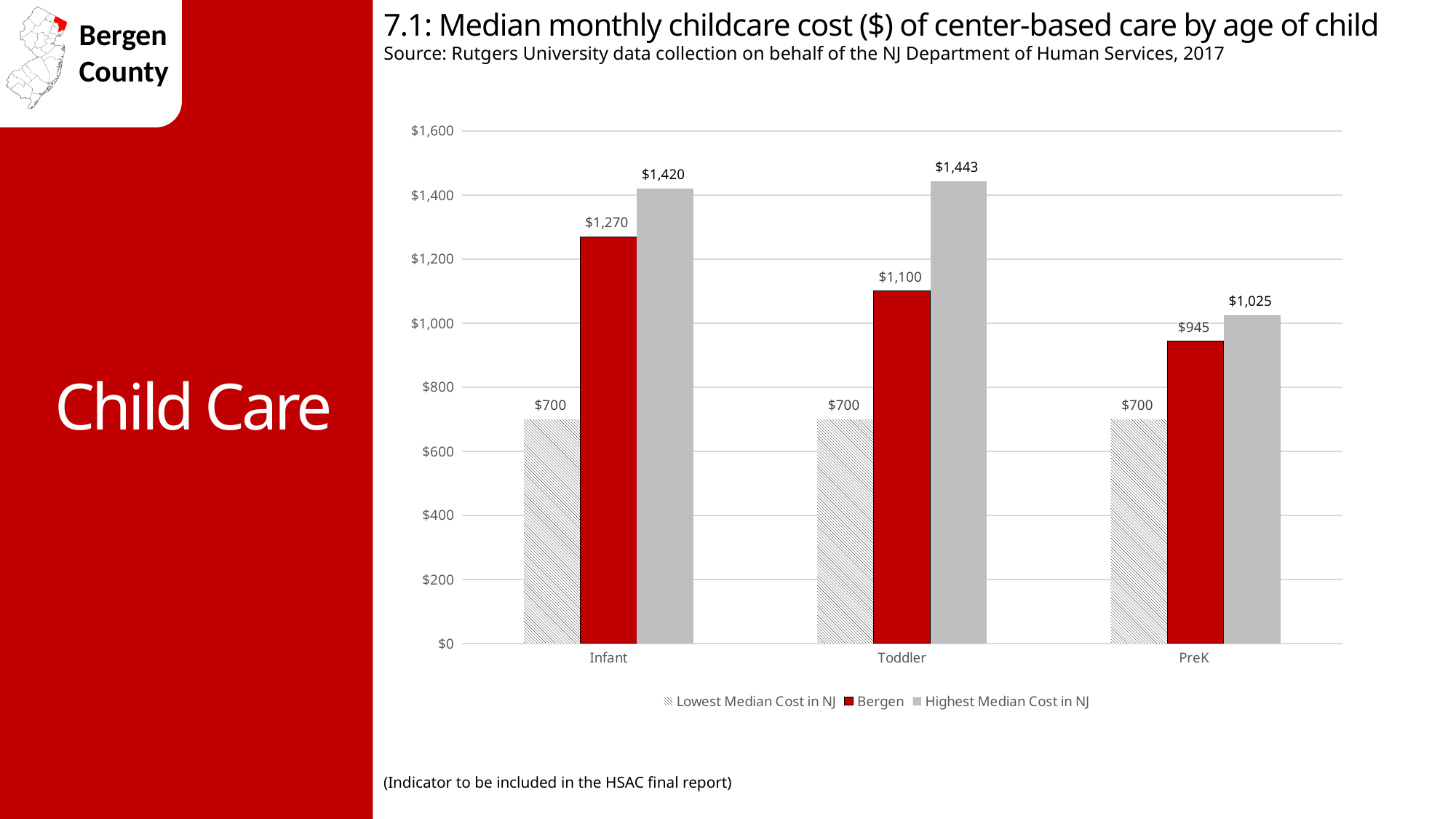
For which age group is the Highest Median Cost in NJ lowest? PreK What is the Highest Median Cost in NJ for Toddler care? $1,443 Which is larger: the Bergen cost for Toddler care or the Bergen cost for PreK care? Toddler Is the Bergen cost for PreK care greater or less than $1,000? less What is the difference between the Highest Median Cost in NJ and the Bergen cost for Toddler care? $343 What kind of chart is shown on the slide? bar chart How many age groups are shown on the x axis? 3 How many series does the legend list? 3 For which age group is the Bergen median monthly cost highest? Infant Which series is shown in red? Bergen What is the median monthly childcare cost for Bergen for Infant care? $1,270 What is the Lowest Median Cost in NJ for PreK care? $700